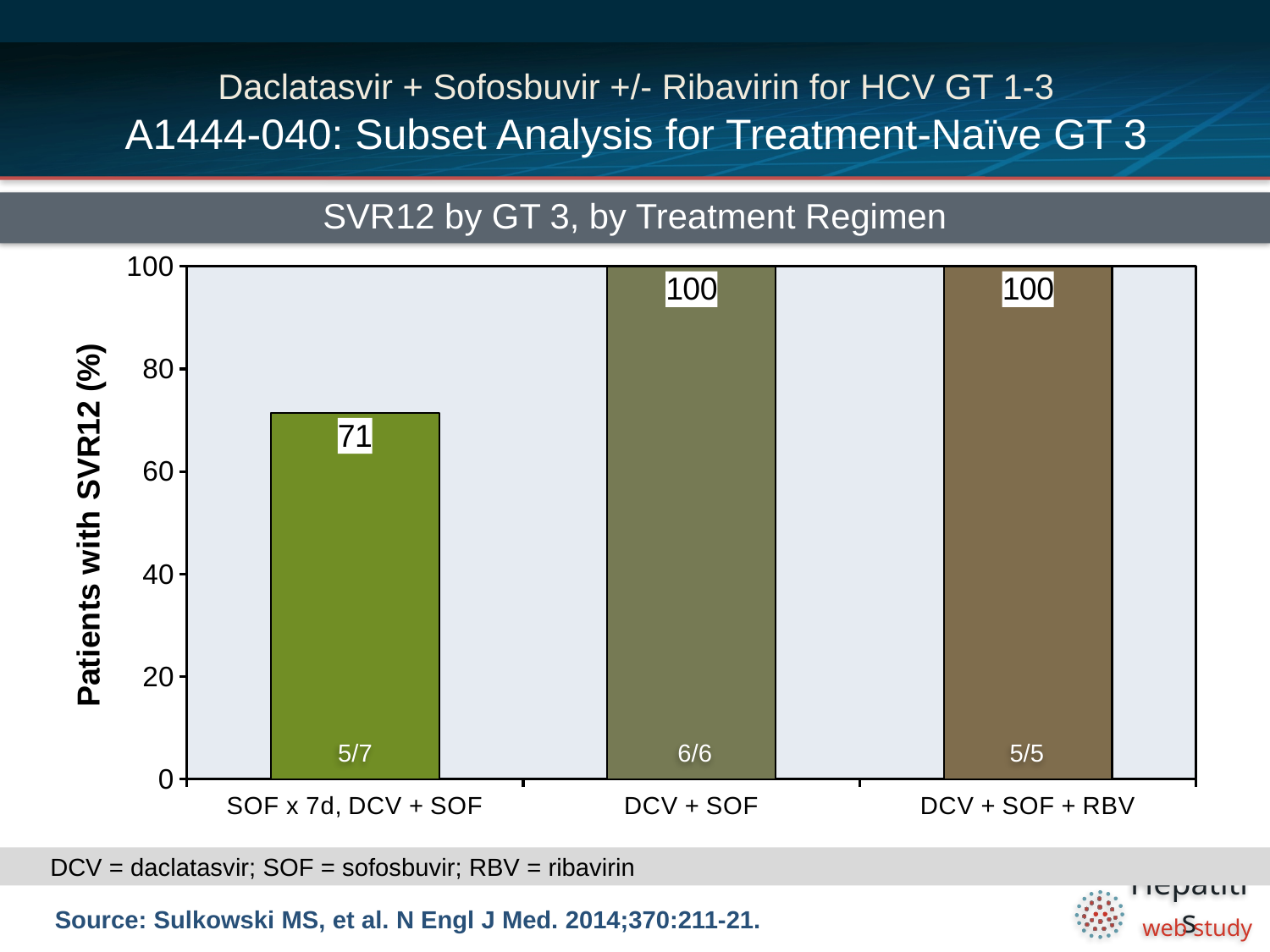
What is the SVR12 value for DCV + SOF + RBV? 100 What fraction of patients is shown at the base of the DCV + SOF + RBV bar? 5/5 What fraction of patients is shown at the base of the SOF x 7d, DCV + SOF bar? 5/7 How many treatment regimens are shown on the x axis? 3 What is the SVR12 value for SOF x 7d, DCV + SOF? 71 Which treatment regimen has the lowest SVR12 value? SOF x 7d, DCV + SOF Which has a higher SVR12 value, SOF x 7d, DCV + SOF or DCV + SOF? DCV + SOF What kind of chart is shown on the slide? bar chart What is the title of the chart? SVR12 by GT 3, by Treatment Regimen Is the value for SOF x 7d, DCV + SOF greater or less than 80? less What is the SVR12 value for DCV + SOF? 100 What is the difference between the SVR12 values for DCV + SOF and SOF x 7d, DCV + SOF? 29